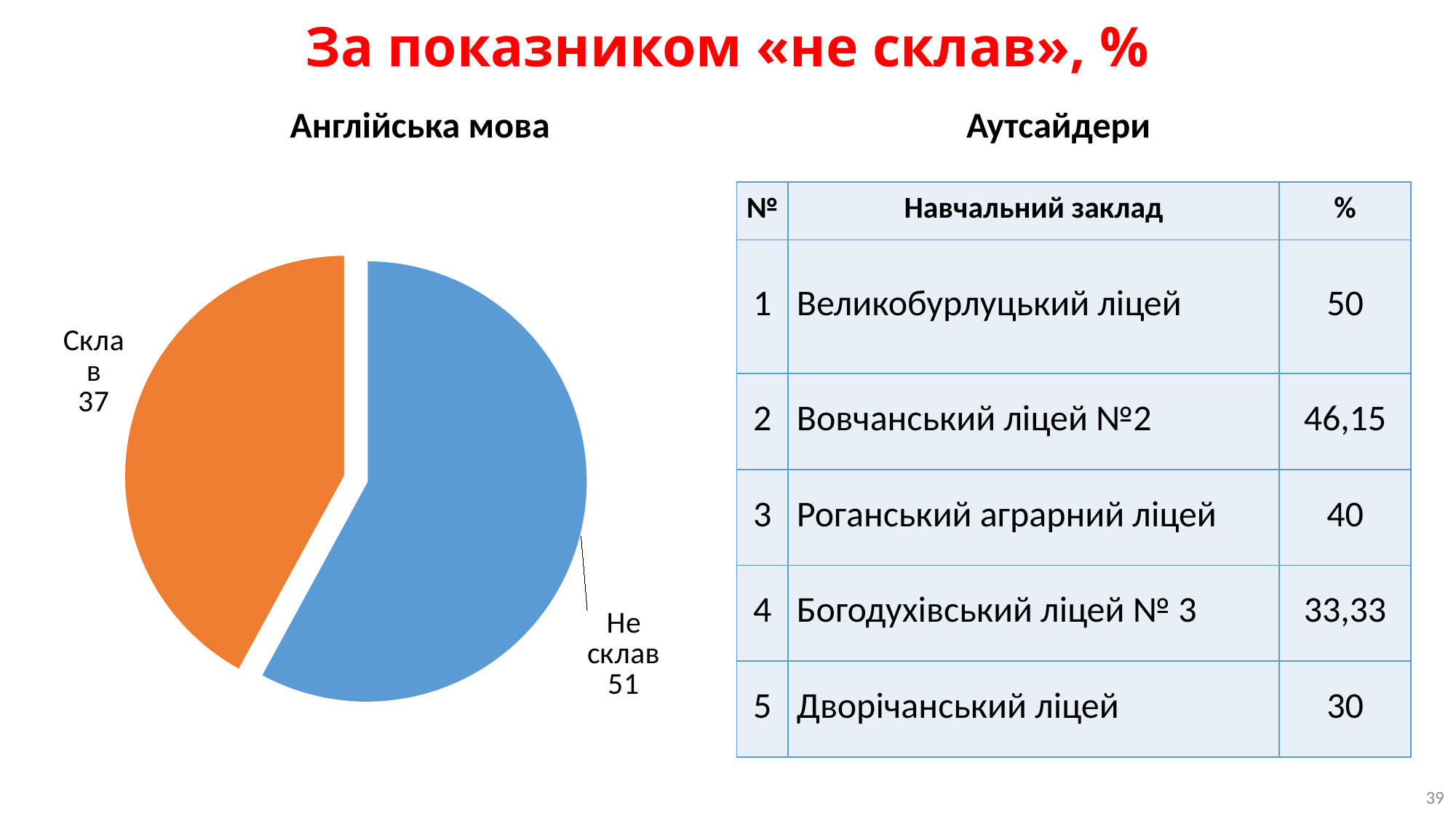
How many slices does the pie chart "Англійська мова" have? 2 In the pie chart "Англійська мова", what is the value for "Не склав"? 51 In the pie chart "Англійська мова", which is larger: "Склав" or "Не склав"? Не склав In the pie chart "Англійська мова", what is the value for "Склав"? 37 In the pie chart "Англійська мова", what colour is the "Не склав" slice? blue In the pie chart "Англійська мова", what colour is the "Склав" slice? orange What kind of chart is shown under the heading "Англійська мова"? pie chart In the pie chart "Англійська мова", which slice is the largest? Не склав In the pie chart "Англійська мова", which slice is the smallest? Склав In the pie chart "Англійська мова", what is the difference between the values for "Не склав" and "Склав"? 14